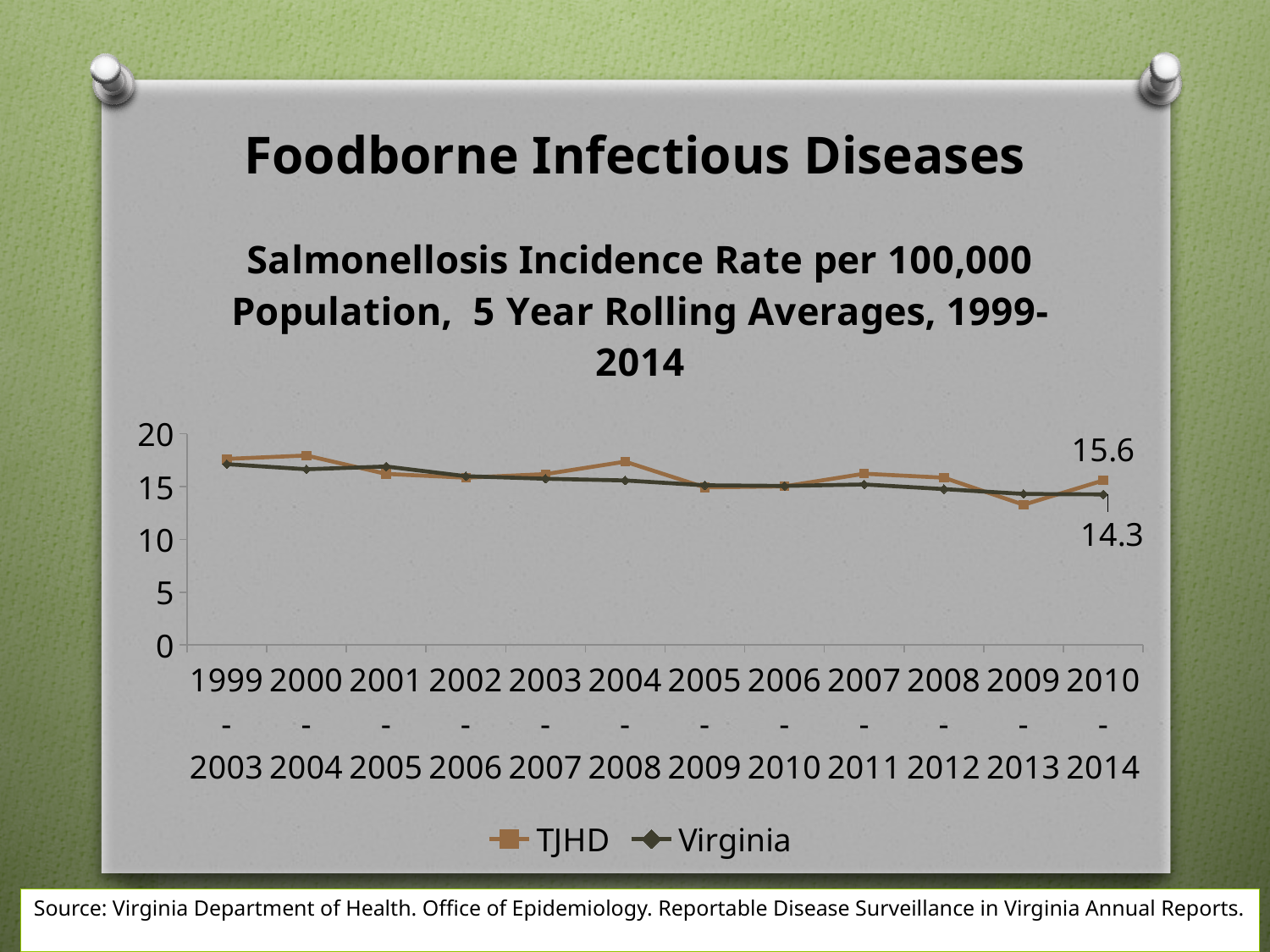
How many series does the legend list? 2 In the 2010-2014 period, which series has the higher rate, TJHD or Virginia? TJHD What is the TJHD salmonellosis incidence rate for the 2010-2014 period? 15.6 What are the two series named in the legend? TJHD and Virginia In which period is the TJHD rate lowest? 2009-2013 What is the difference between the TJHD and Virginia rates for the 2010-2014 period? 1.3 How many rolling-average periods are shown on the x axis? 12 Is the TJHD value for the 1999-2003 period greater or less than 15? greater Does the Virginia rate generally rise or fall from 1999-2003 to 2010-2014? Fall What is the Virginia salmonellosis incidence rate for the 2010-2014 period? 14.3 Is the TJHD value for the 2009-2013 period greater or less than 15? less What kind of chart is shown on the slide? Line chart